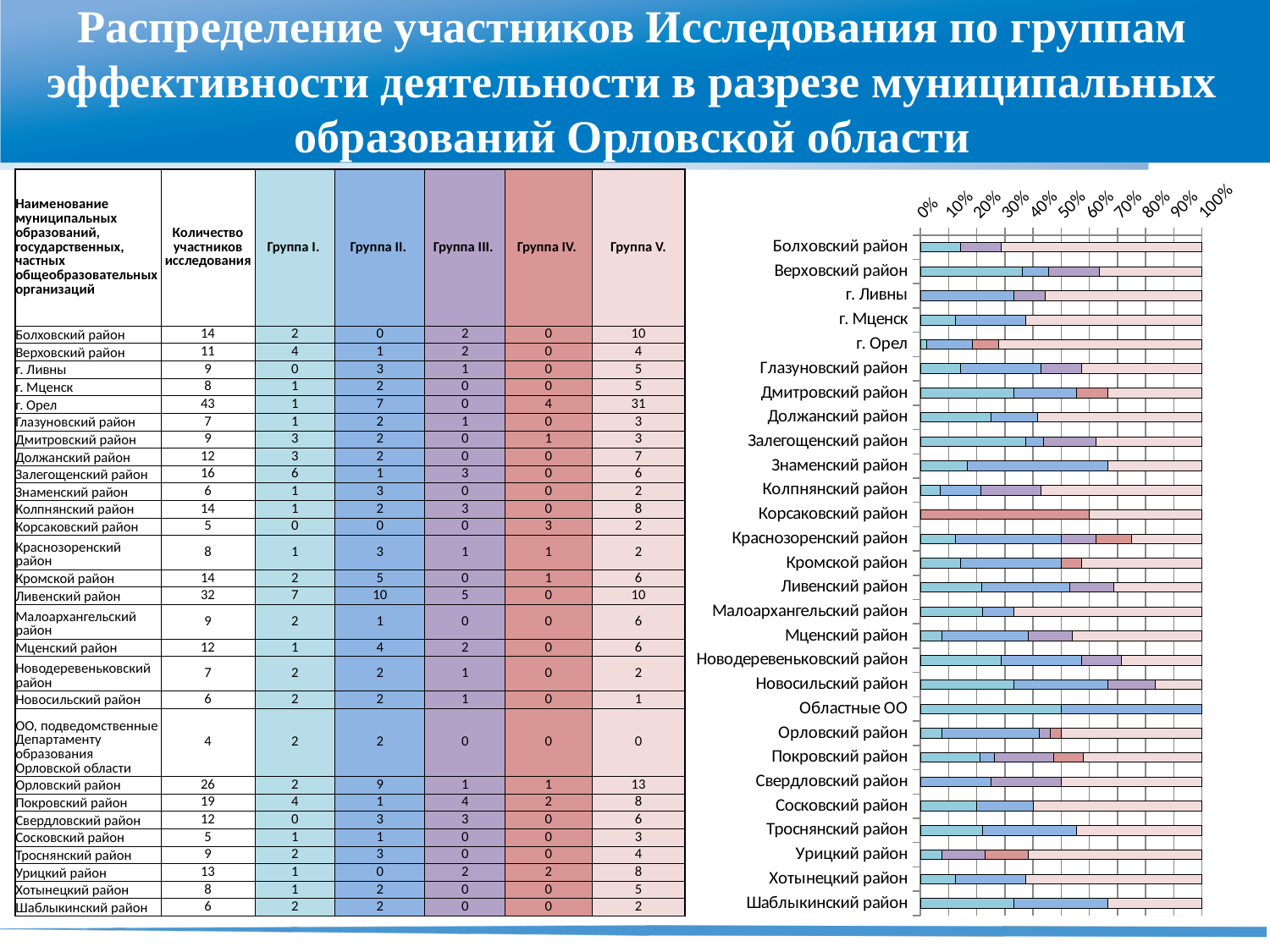
On the bar chart, which category has the largest red (Группа IV) segment? Корсаковский район On the bar chart, is the light-pink (Группа V) share for Малоархангельский район greater or less than 60%? greater On the bar chart, which category has the largest light-blue (Группа I) segment? Областные ОО On the bar chart, is the light-blue (Группа I) share for г. Орел greater or less than 10%? less On the bar chart, is the light-pink (Группа V) share for г. Орел greater or less than 60%? greater Which category is listed first (at the top) of the bar chart? Болховский район How many municipal categories are plotted on the bar chart? 28 What is the range of the percentage axis on the bar chart? 0% to 100% What kind of chart is shown on the right side of the slide? bar chart On the bar chart, which has the larger light-blue (Группа I) share: Залегощенский район or г. Орел? Залегощенский район